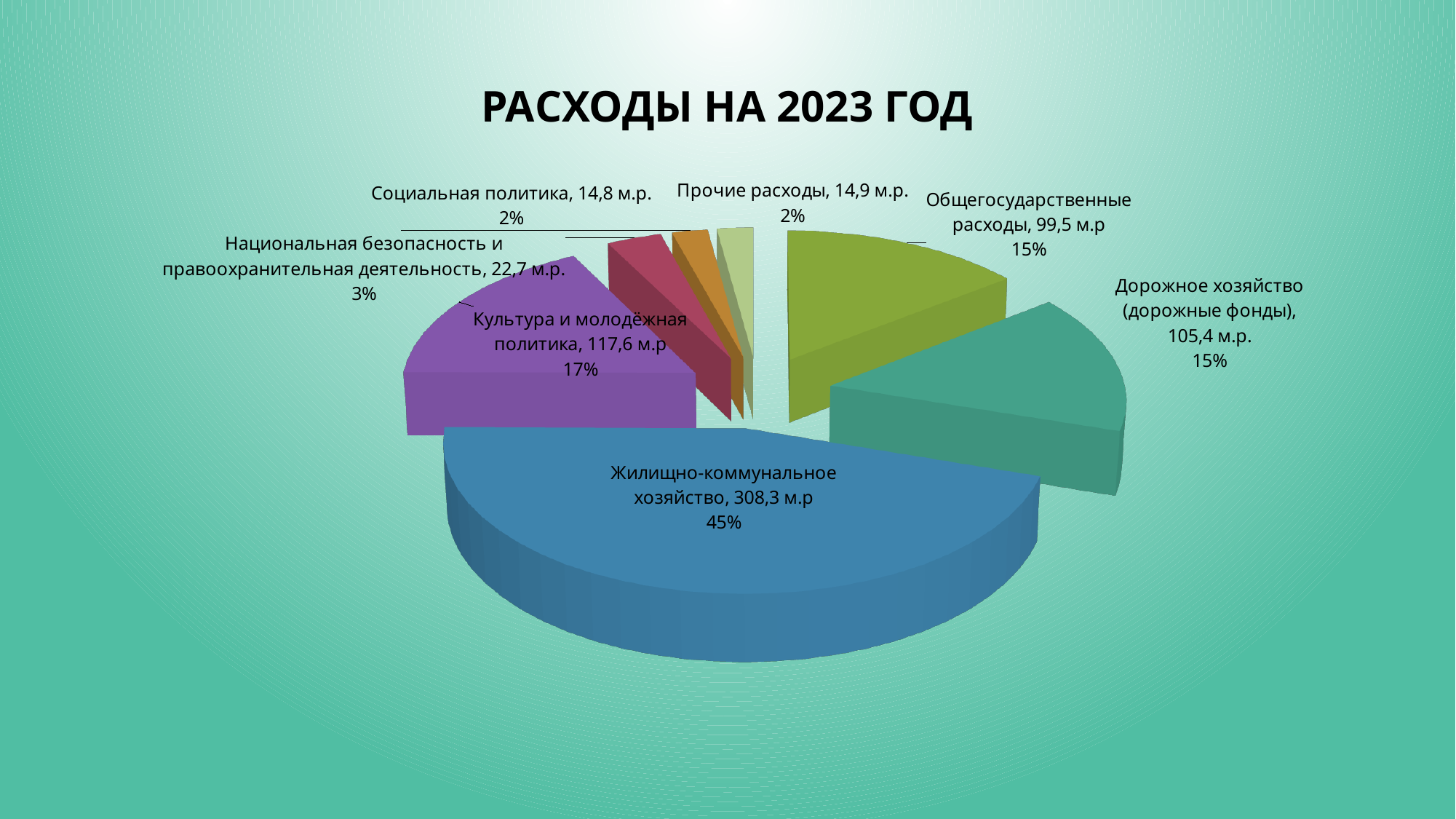
What share of the pie does Культура и молодёжная политика represent? 17% What is the value for Национальная безопасность и правоохранительная деятельность? 22,7 м.р. Which category has the smallest value? Социальная политика What is the title of the chart? РАСХОДЫ НА 2023 ГОД What is the value for Дорожное хозяйство (дорожные фонды)? 105,4 м.р. What is the difference between the values for Жилищно-коммунальное хозяйство and Культура и молодёжная политика? 190,7 м.р What share of the pie does Общегосударственные расходы represent? 15% What is the value for Жилищно-коммунальное хозяйство? 308,3 м.р Which category has the largest share of the pie? Жилищно-коммунальное хозяйство What kind of chart is shown on the slide? Pie chart Which is larger: the value for Дорожное хозяйство (дорожные фонды) or Общегосударственные расходы? Дорожное хозяйство (дорожные фонды) How many categories (slices) does the pie chart have? 7